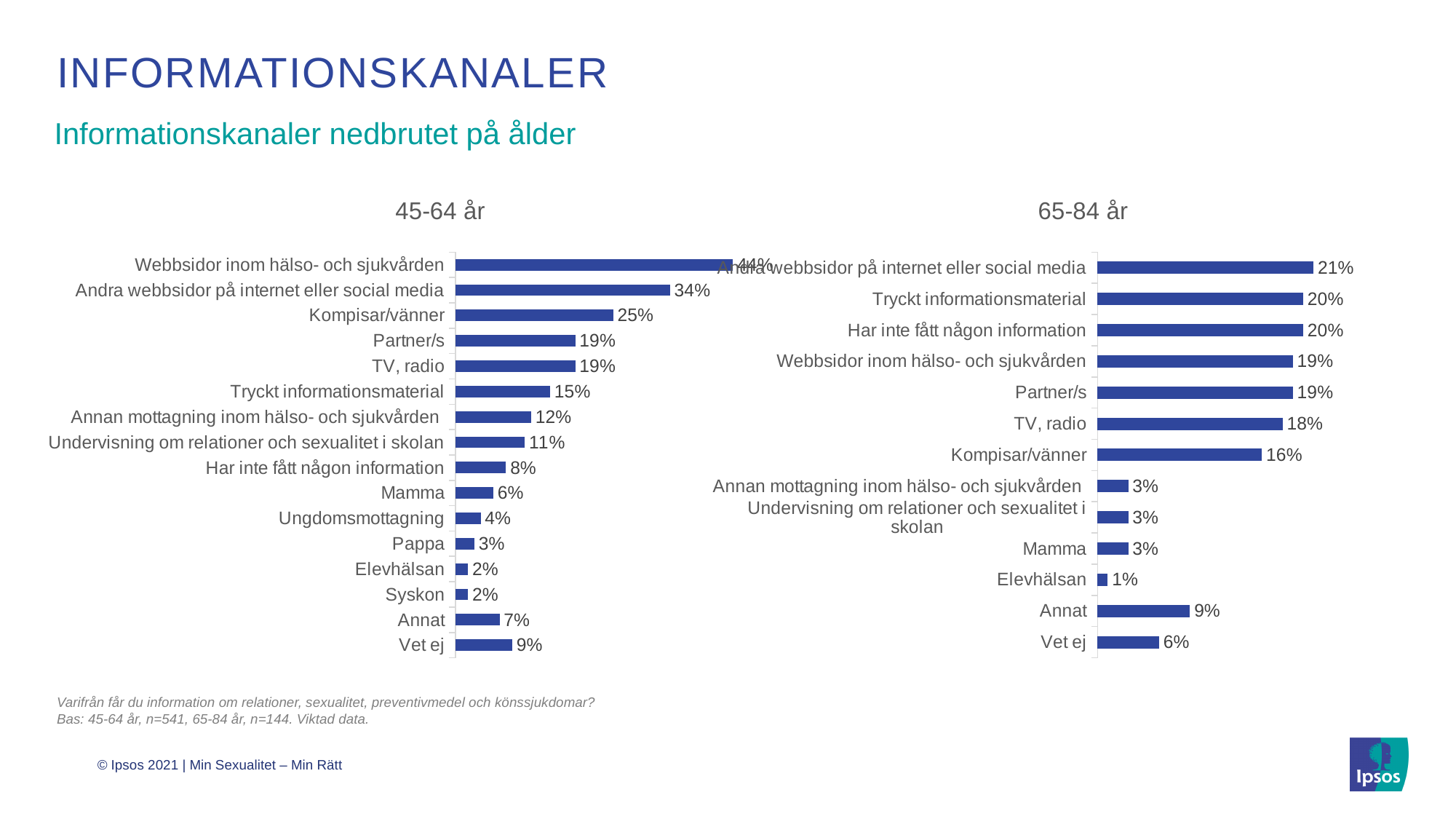
In the 65-84 år chart, what is the value for Tryckt informationsmaterial? 20% In the 65-84 år chart, which category has the lowest value? Elevhälsan How many categories are shown in the 45-64 år chart? 16 Which is larger in the 45-64 år chart: Mamma or Pappa? Mamma In the 45-64 år chart, what is the difference between Webbsidor inom hälso- och sjukvården and Andra webbsidor på internet eller social media? 10 percentage points In the 45-64 år chart, what is the value for Kompisar/vänner? 25% In the 65-84 år chart, which category has the highest value? Andra webbsidor på internet eller social media Which is larger in the 65-84 år chart: Annat or Vet ej? Annat In the 45-64 år chart, which category has the highest value? Webbsidor inom hälso- och sjukvården What type of chart is used for the 65-84 år data? Bar chart In the 65-84 år chart, what is the difference between Kompisar/vänner and Vet ej? 10 percentage points How many categories are shown in the 65-84 år chart? 13